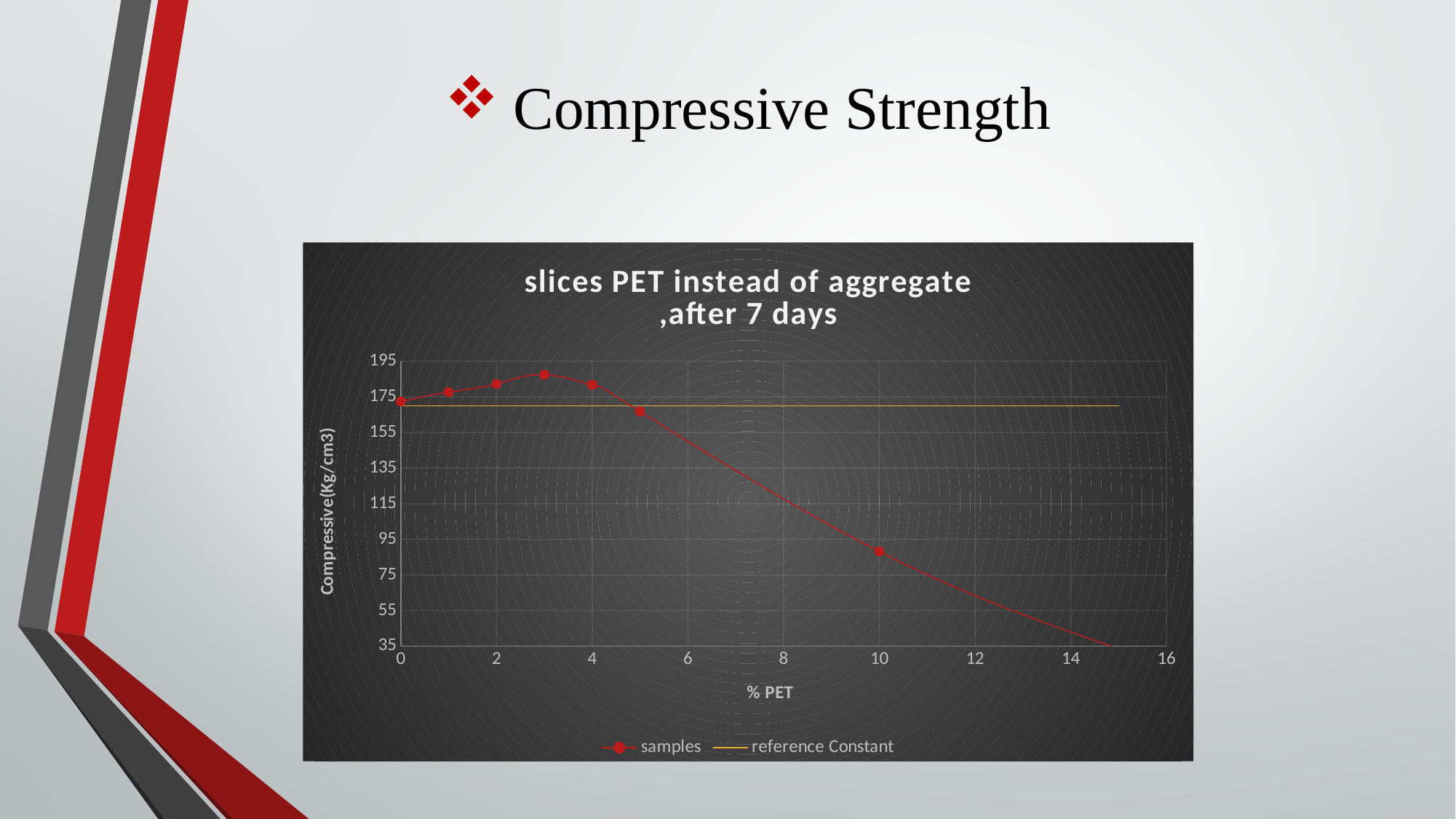
Which has the higher compressive strength for the samples series, 2% PET or 3% PET? 3% PET What is the title of the chart? slices PET instead of aggregate ,after 7 days How many series does the legend list? 2 Is the compressive strength of the samples at 3% PET greater or less than 175? greater Is the compressive strength of the samples at 0% PET greater or less than 155? greater Is the compressive strength of the samples at 5% PET greater or less than 175? less Which has the higher compressive strength for the samples series, 5% PET or 10% PET? 5% PET How does the samples series change as % PET increases beyond 3? It falls At which % PET does the samples series reach its highest compressive strength? 3 What kind of chart is shown on the slide? Line chart What is the label of the y axis? Compressive(Kg/cm3)